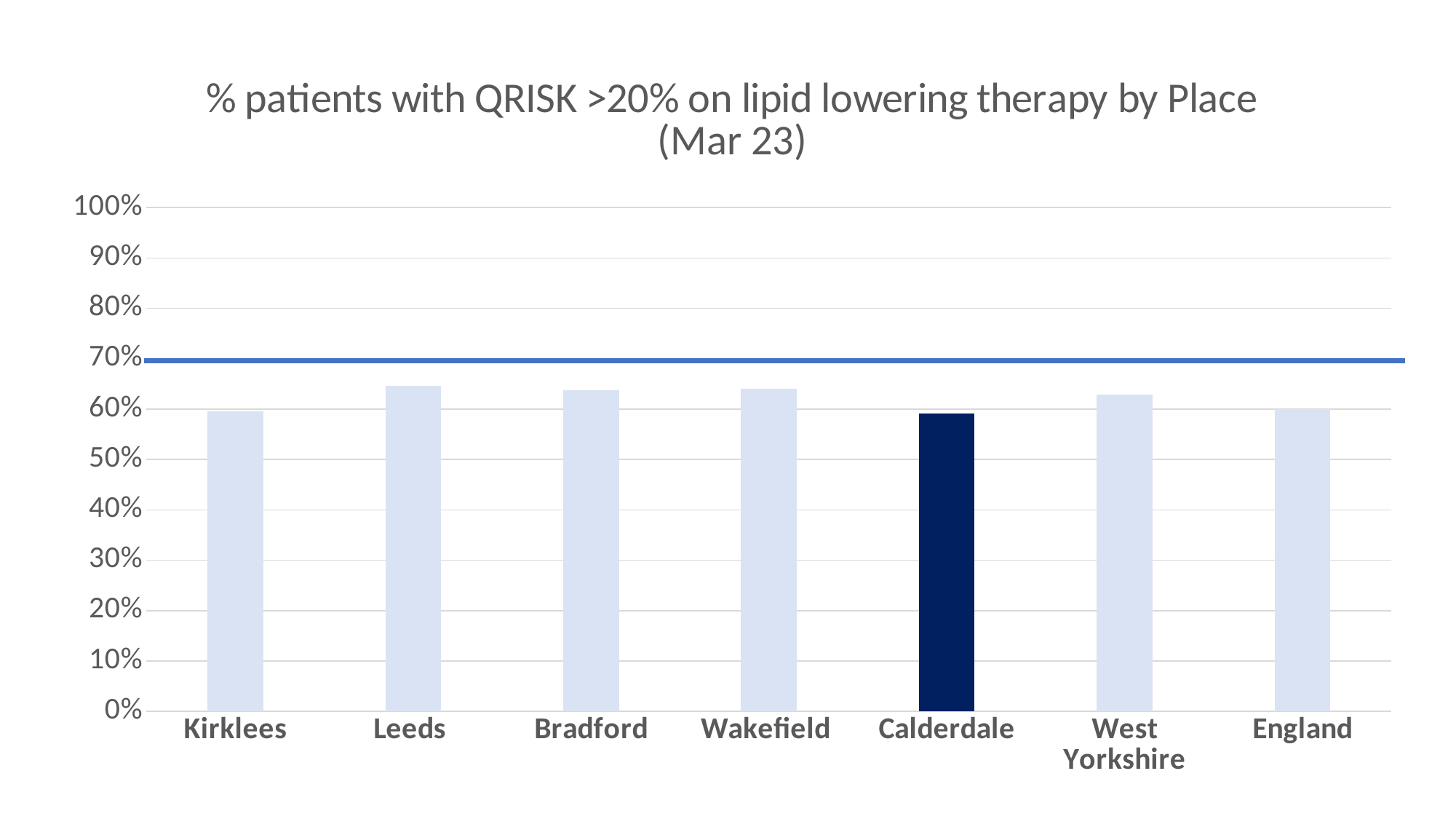
Which is larger, the value for Bradford or the value for England? Bradford What is the title of the chart? % patients with QRISK >20% on lipid lowering therapy by Place (Mar 23) What kind of chart is shown on the slide? bar chart Which bar is highlighted in dark blue? Calderdale Which is larger, the value for Calderdale or the value for Leeds? Leeds Is the value for West Yorkshire greater or less than 50%? greater Is the value for Leeds greater or less than 60%? greater Is the value for England greater or less than 70%? less How many places (categories) are shown on the x axis? 7 Which is larger, the value for Leeds or the value for Kirklees? Leeds